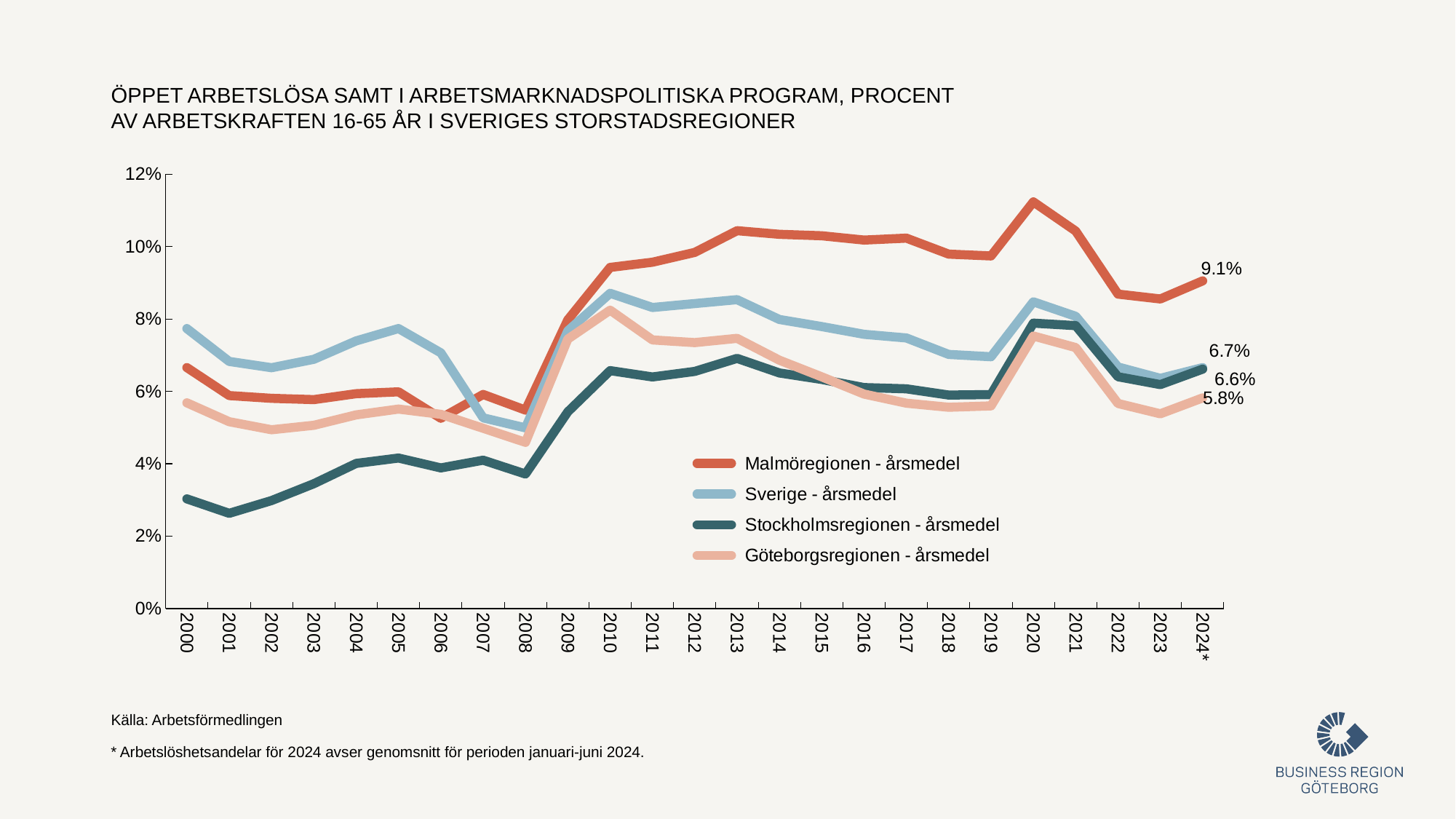
What kind of chart is shown on the slide? line chart What source is cited below the chart? Arbetsförmedlingen Which series has the lowest value in 2024*? Göteborgsregionen - årsmedel What is the difference between the 2024* values for Malmöregionen and Göteborgsregionen? 3.3 percentage points What is the value for Sverige - årsmedel in 2024*? 6.7% What is the value for Göteborgsregionen - årsmedel in 2024*? 5.8% Which series has the highest value in 2024*? Malmöregionen - årsmedel How many series does the legend list? 4 Is the value for Stockholmsregionen - årsmedel in 2001 greater or less than 4%? less Is the value for Malmöregionen - årsmedel in 2020 greater or less than 10%? greater In 2000, which is larger: the value for Sverige - årsmedel or for Stockholmsregionen - årsmedel? Sverige - årsmedel What is the value for Malmöregionen - årsmedel in 2024*? 9.1%